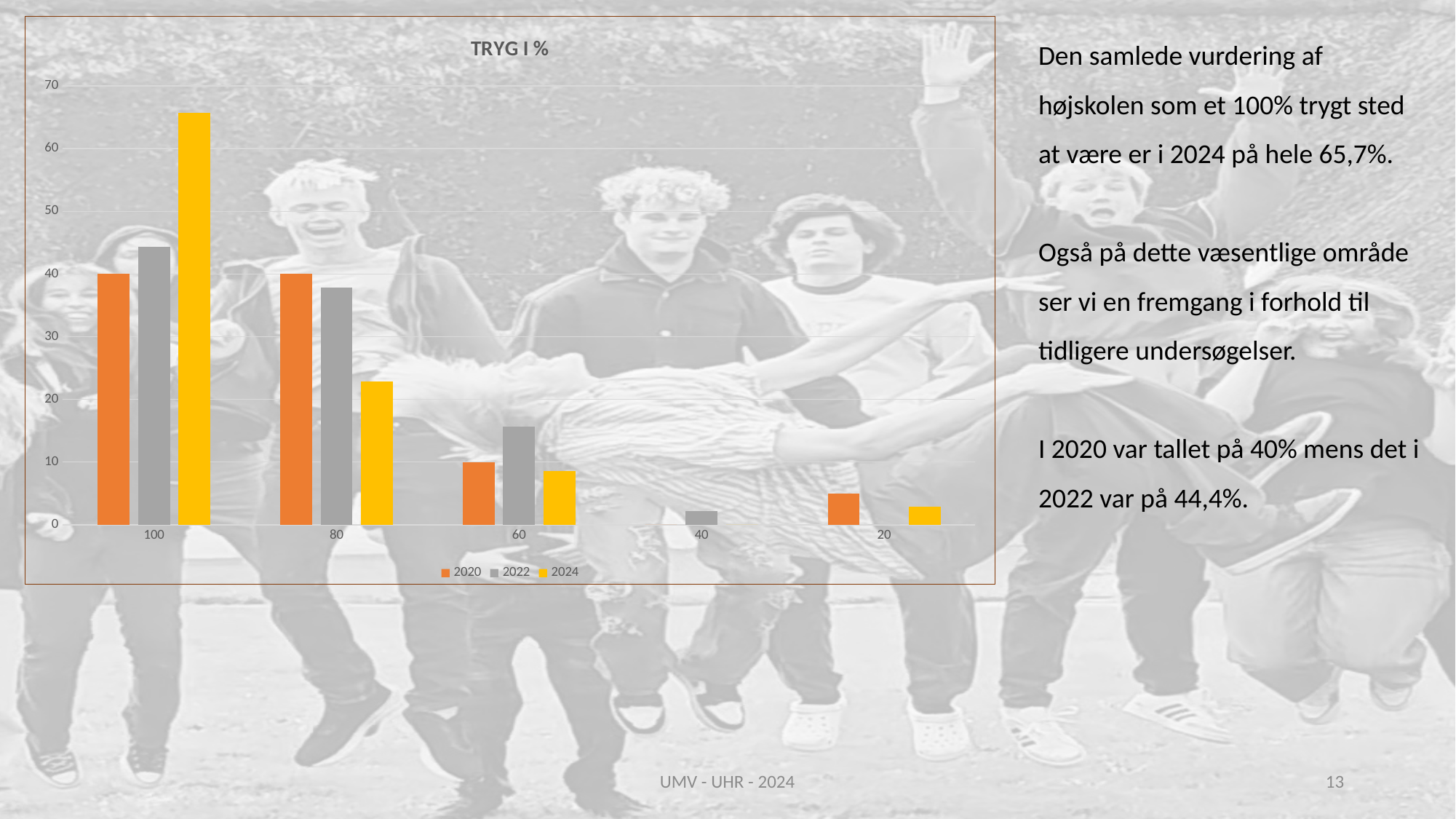
What is the value for 2020 in the 100 category? 40 What kind of chart is shown on the slide? bar chart How many series does the legend list? 3 Which series has the highest value in the 100 category? 2024 In the 60 category, which is larger: the value for 2022 or the value for 2024? 2022 Is the value for 2024 in the 100 category greater or less than 60? greater Is the value for 2024 in the 60 category greater or less than 10? less How many categories are shown on the x axis? 5 What is the title of the chart? TRYG I % Do the values for the 2024 series rise or fall from the 100 category to the 60 category? fall What is the value for 2020 in the 60 category? 10 Is the value for 2022 in the 80 category greater or less than 40? less